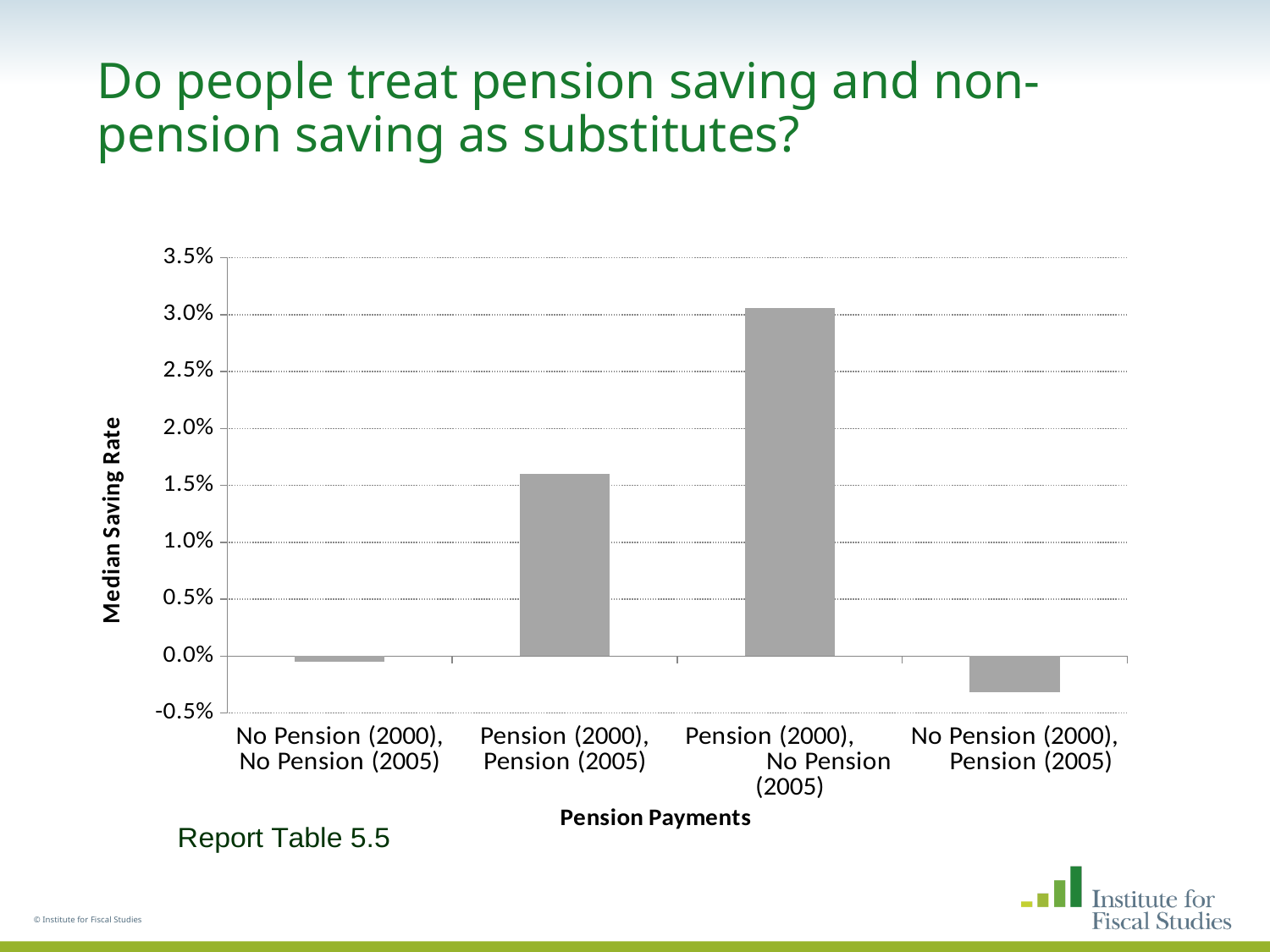
What is the title of the horizontal axis of the chart? Pension Payments What is the title of the vertical axis of the chart? Median Saving Rate Which is larger: the median saving rate for Pension (2000), Pension (2005) or for Pension (2000), No Pension (2005)? Pension (2000), No Pension (2005) Is the value for Pension (2000), No Pension (2005) greater or less than 2.5%? greater Which category has the lowest median saving rate? No Pension (2000), Pension (2005) What kind of chart is shown on the slide? bar chart Which category has the highest median saving rate? Pension (2000), No Pension (2005) Is the value for No Pension (2000), No Pension (2005) greater or less than 0.5%? less Which is larger: the median saving rate for No Pension (2000), No Pension (2005) or for No Pension (2000), Pension (2005)? No Pension (2000), No Pension (2005) Is the value for Pension (2000), Pension (2005) greater or less than 1.0%? greater How many categories are shown on the x axis of the chart? 4